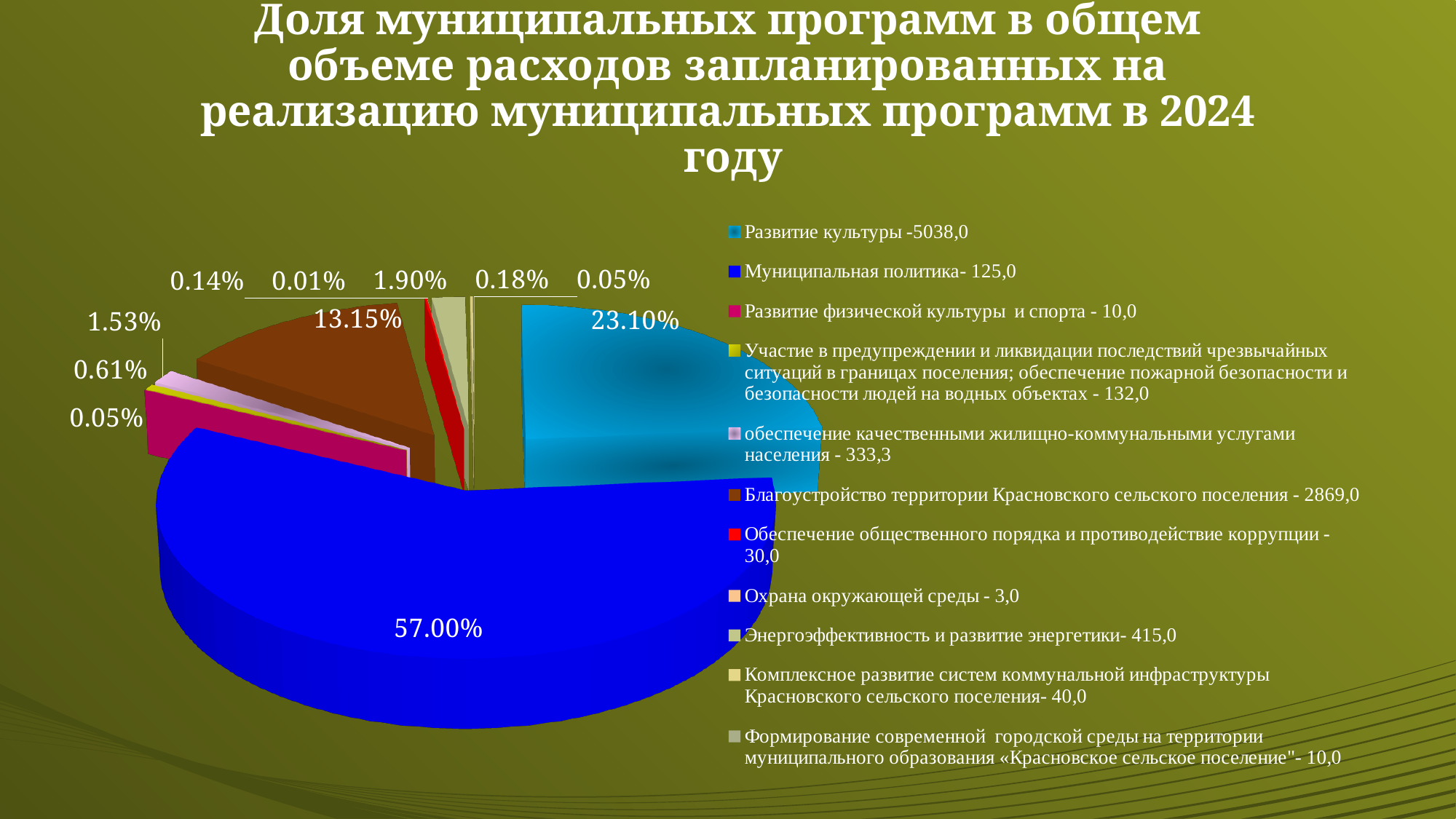
What value is given in the legend for Благоустройство территории Красновского сельского поселения? 2869,0 What kind of chart is shown on the slide? pie chart What share of the pie is labelled for Развитие культуры (the cyan slice)? 23.10% What share of the pie does the largest slice (Муниципальная политика) have? 57.00% Which slice is larger: Развитие культуры or Благоустройство территории Красновского сельского поселения? Развитие культуры How many entries does the legend list? 11 What is the difference in percentage points between the 57.00% slice and the 23.10% slice? 33.90% Which category has the largest share of the pie? Муниципальная политика What share of the pie is labelled for Благоустройство территории Красновского сельского поселения (the brown slice)? 13.15% What value is given in the legend for Энергоэффективность и развитие энергетики? 415,0 How many percentage data labels are shown on the pie chart? 11 What is the smallest percentage label shown on the pie chart? 0.01%